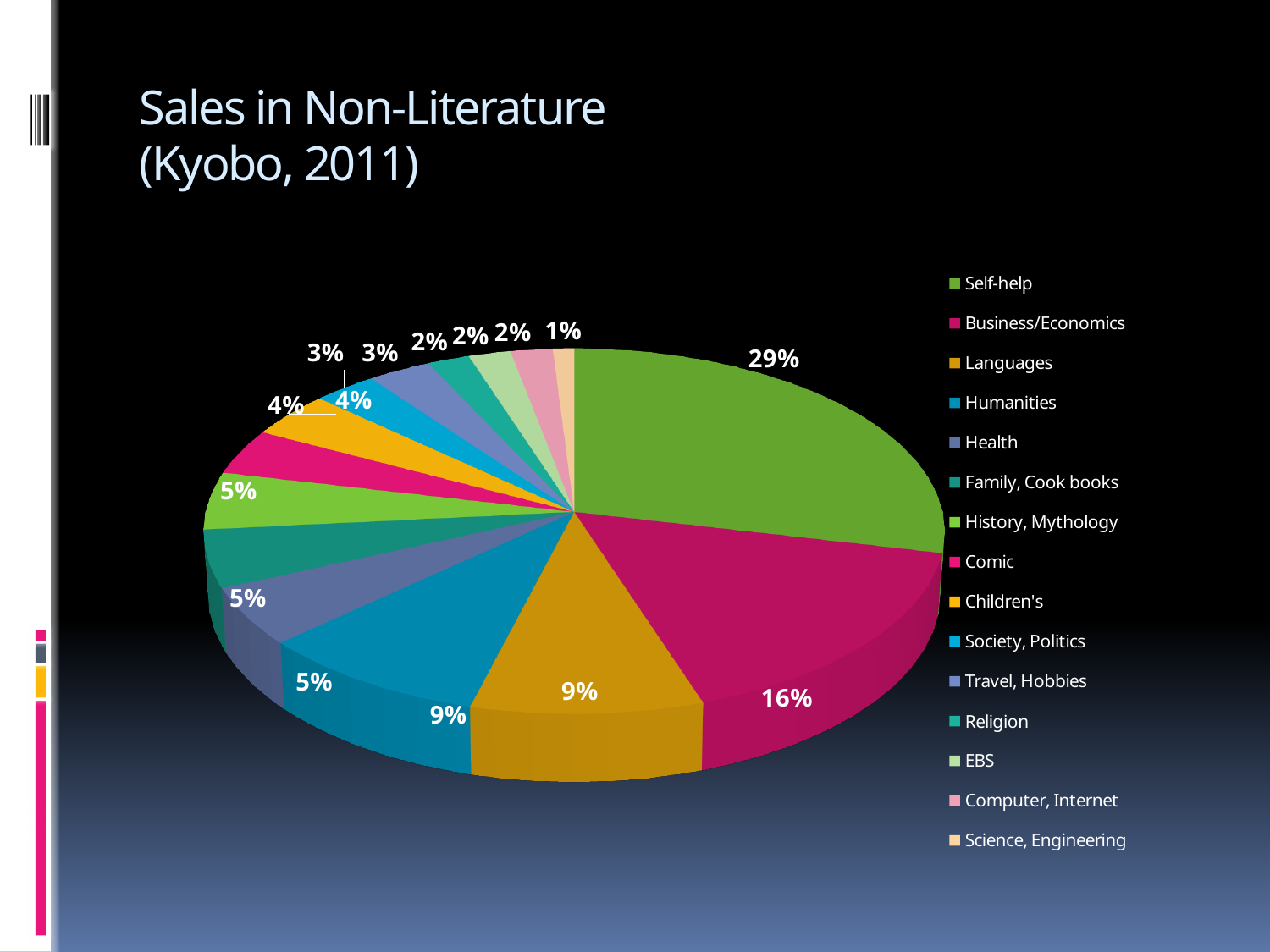
What share of sales does Self-help account for? 29% Which has a larger share of sales, Business/Economics or Humanities? Business/Economics What colour is the Self-help slice? green What share of sales does Languages account for? 9% What share of sales does Science, Engineering account for? 1% What share of sales does Business/Economics account for? 16% How many categories does the legend list? 15 How many percentage points larger is the Self-help share than the Business/Economics share? 13 Which category has the smallest share of sales? Science, Engineering What is the title of the chart slide? Sales in Non-Literature (Kyobo, 2011) Which category has the largest share of sales? Self-help What type of chart is shown on the slide? pie chart